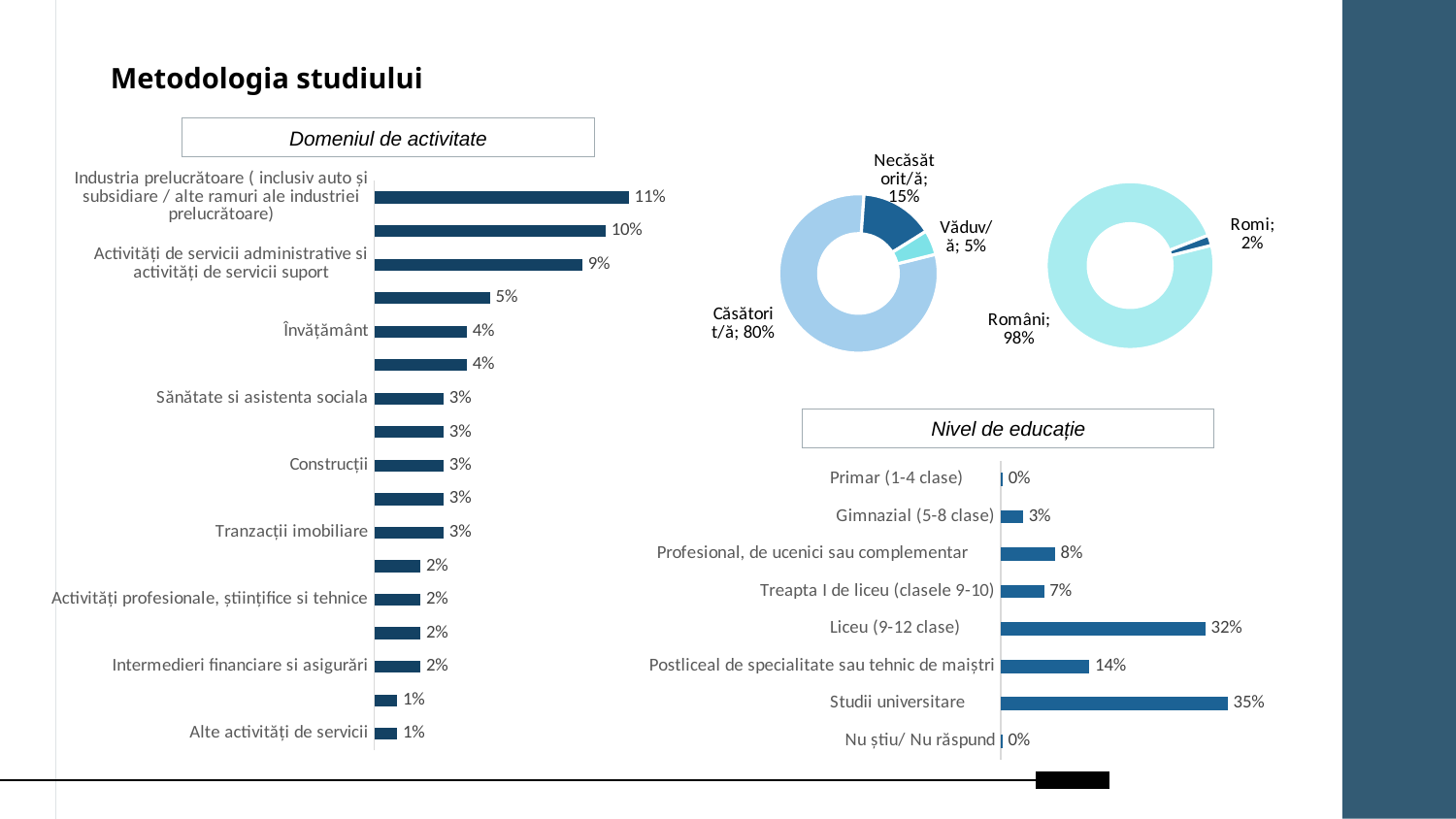
In the 'Nivel de educație' chart, which category has the highest value? Studii universitare In the 'Nivel de educație' chart, what is the difference between Studii universitare and Postliceal de specialitate sau tehnic de maiștri? 21% In the ethnicity donut chart (top right), what is the share for Romi? 2% In the 'Nivel de educație' chart, which is larger: Profesional, de ucenici sau complementar or Treapta I de liceu (clasele 9-10)? Profesional, de ucenici sau complementar In the 'Nivel de educație' chart, what is the value for Liceu (9-12 clase)? 32% In the 'Domeniul de activitate' chart, what is the value for Industria prelucrătoare? 11% In the marital status donut chart (top middle), what is the share for Căsătorit/ă? 80% In the 'Domeniul de activitate' chart, what is the difference between Industria prelucrătoare and Intermedieri financiare si asigurări? 9% How many categories does the 'Nivel de educație' chart show? 8 In the 'Domeniul de activitate' chart, what is the value for Învățământ? 4% What kind of chart is the 'Domeniul de activitate' chart? Bar chart In the 'Domeniul de activitate' chart, what is the value for Activități de servicii administrative si activități de servicii suport? 9%